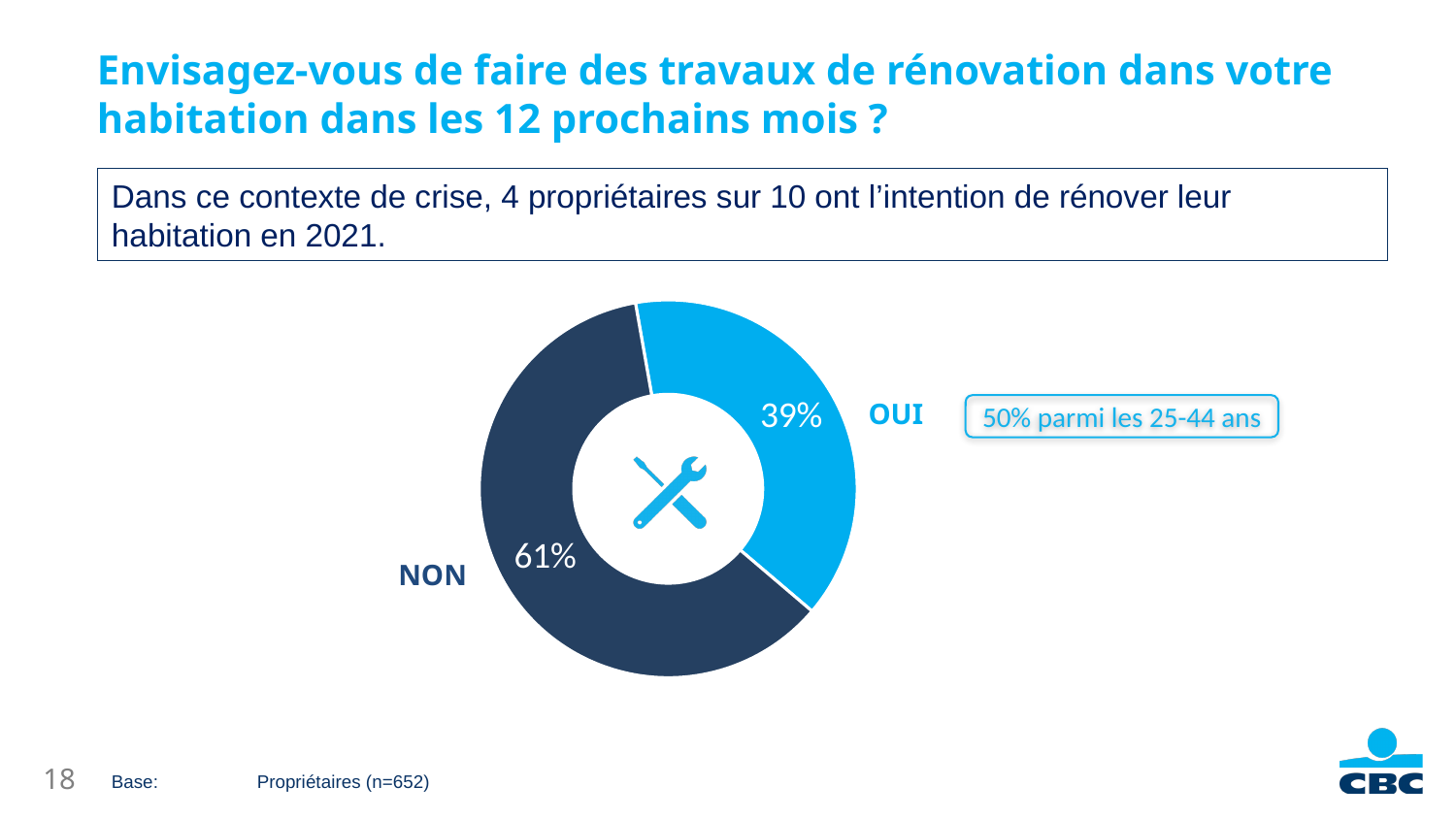
What is the difference in percentage points between NON and OUI? 22 According to the callout next to the chart, what is the OUI share among 25-44 year olds? 50% What share of the pie does the NON slice represent? 61% Which answer has the larger share, OUI or NON? NON How many categories does the chart show? 2 What percentage of respondents answered NON? 61% What percentage of respondents answered OUI? 39% Which colour is used for the OUI slice? Light blue Which category has the smallest share in the chart? OUI What kind of chart is shown on the slide? Pie chart (doughnut) What is the total of the two slices shown in the chart? 100% Which category has the largest share in the chart? NON